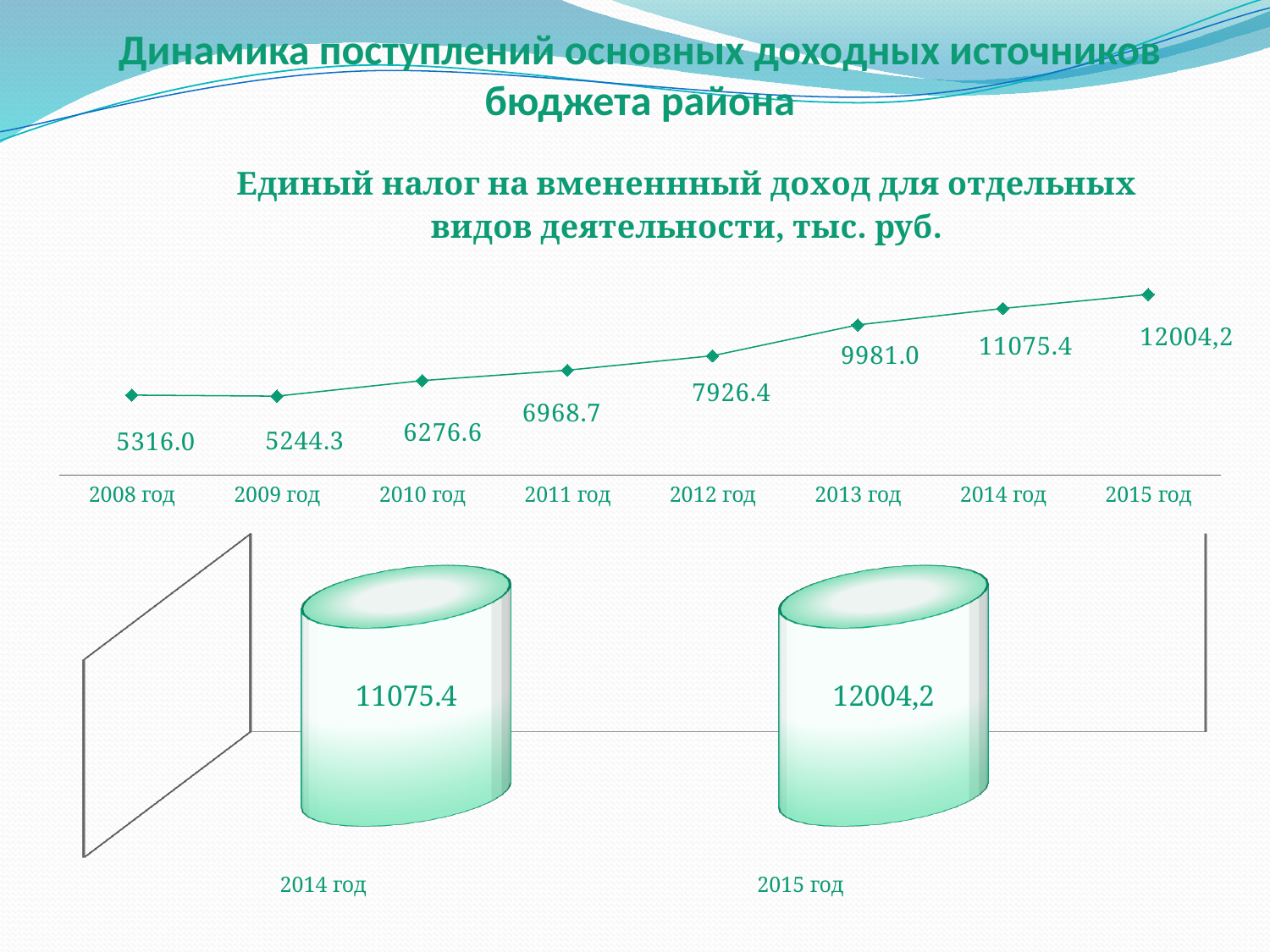
In the top line chart, which is larger, the value for 2008 год or 2009 год? 2008 год In the top line chart, what is the value for 2010 год? 6276.6 In the top line chart, what is the value for 2013 год? 9981.0 In the top line chart, which year has the highest value? 2015 год In the bottom bar chart, what is the value for 2015 год? 12004,2 In the top line chart, which year has the lowest value? 2009 год In the top line chart, what is the value for 2012 год? 7926.4 How many data points does the top line chart show? 8 In the bottom bar chart, what is the difference between the values for 2015 год and 2014 год? 928.8 In the top line chart, what is the difference between the values for 2013 год and 2012 год? 2054.6 What kind of chart is the top chart on the slide? line chart In the top line chart, do the values generally rise or fall from 2008 год to 2015 год? rise